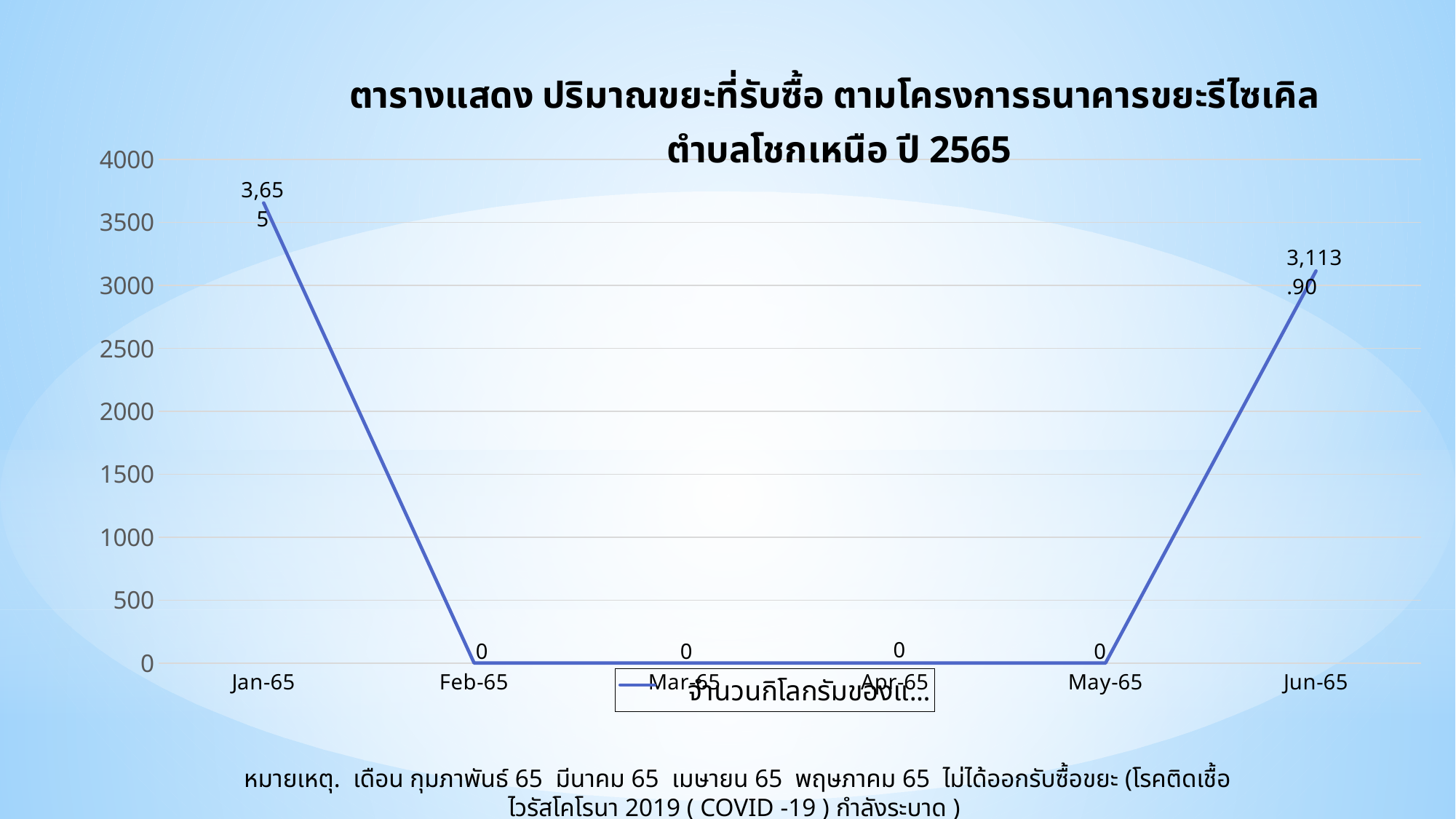
What is the value for Jan-65? 3,655 How many months have a value of 0? 4 How many series does the legend list? 1 Is the value for Jun-65 greater or less than 3000? greater Which of Jan-65 and Jun-65 has the larger value? Jan-65 How many months (data points) are plotted on the x axis? 6 What is the value for Feb-65? 0 What is the value for Jun-65? 3,113.90 Is the value for Jan-65 greater or less than 3500? greater What is the value for Apr-65? 0 What type of chart is shown on the slide? line chart Which month has the highest value? Jan-65